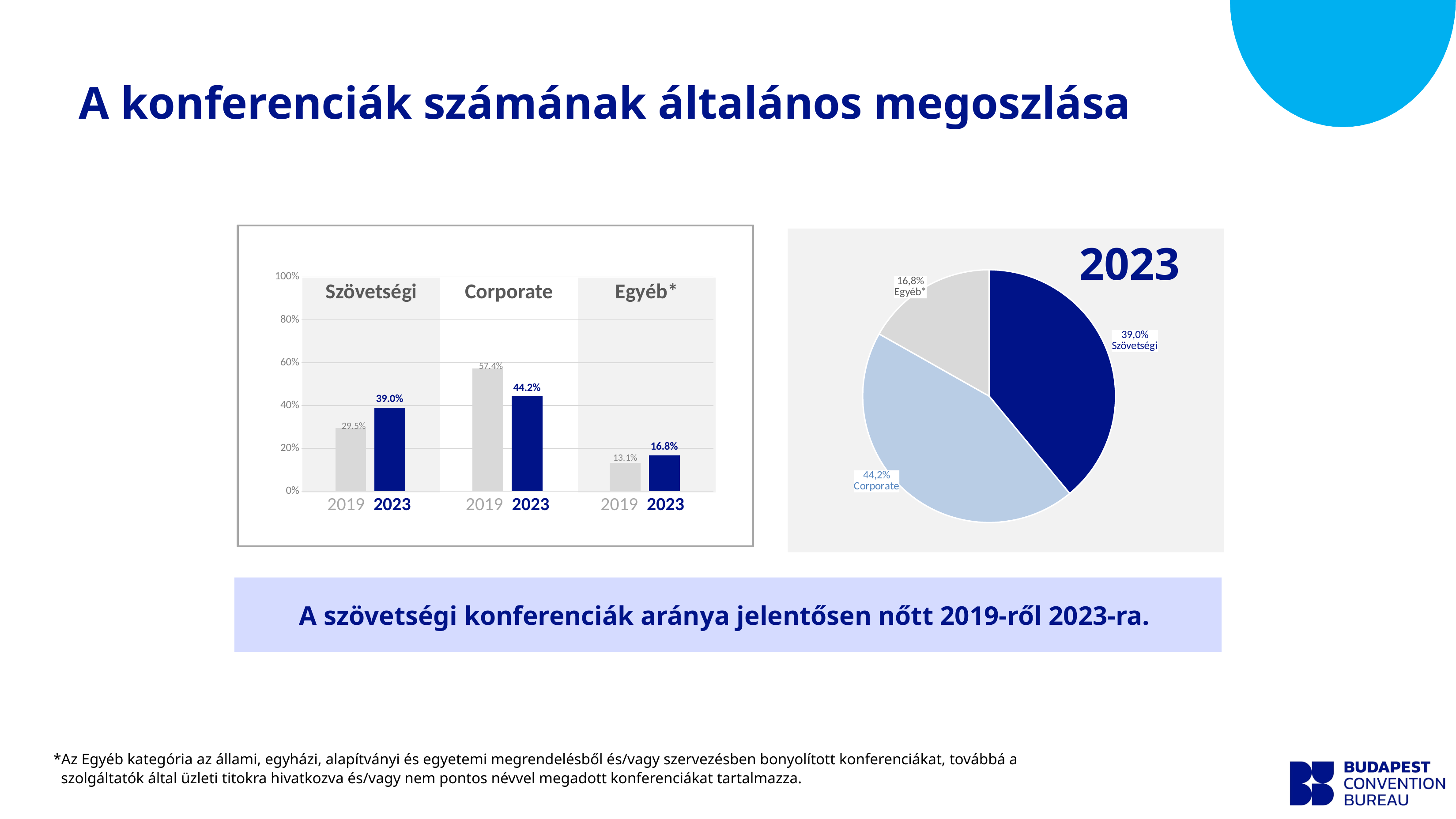
In the bar chart on the left, what is the value for Szövetségi in 2023? 39.0% In the bar chart on the left, is the 2019 value for Corporate greater or less than 40%? greater In the bar chart on the left, what is the value for Egyéb* in 2019? 13.1% In the bar chart on the left, what is the difference between the Corporate values for 2019 and 2023? 13.2% In the pie chart on the right, which slice is the smallest? Egyéb* In the bar chart on the left, which category has the highest 2019 value? Corporate In the bar chart on the left, which category has the lowest 2023 value? Egyéb* In the bar chart on the left, which is larger for Szövetségi: the 2019 value or the 2023 value? 2023 What kind of chart is shown on the right side of the slide? Pie chart In the bar chart on the left, how many categories are shown? 3 In the bar chart on the left, what is the value for Corporate in 2019? 57.4% In the pie chart on the right, what share does Corporate have? 44,2%